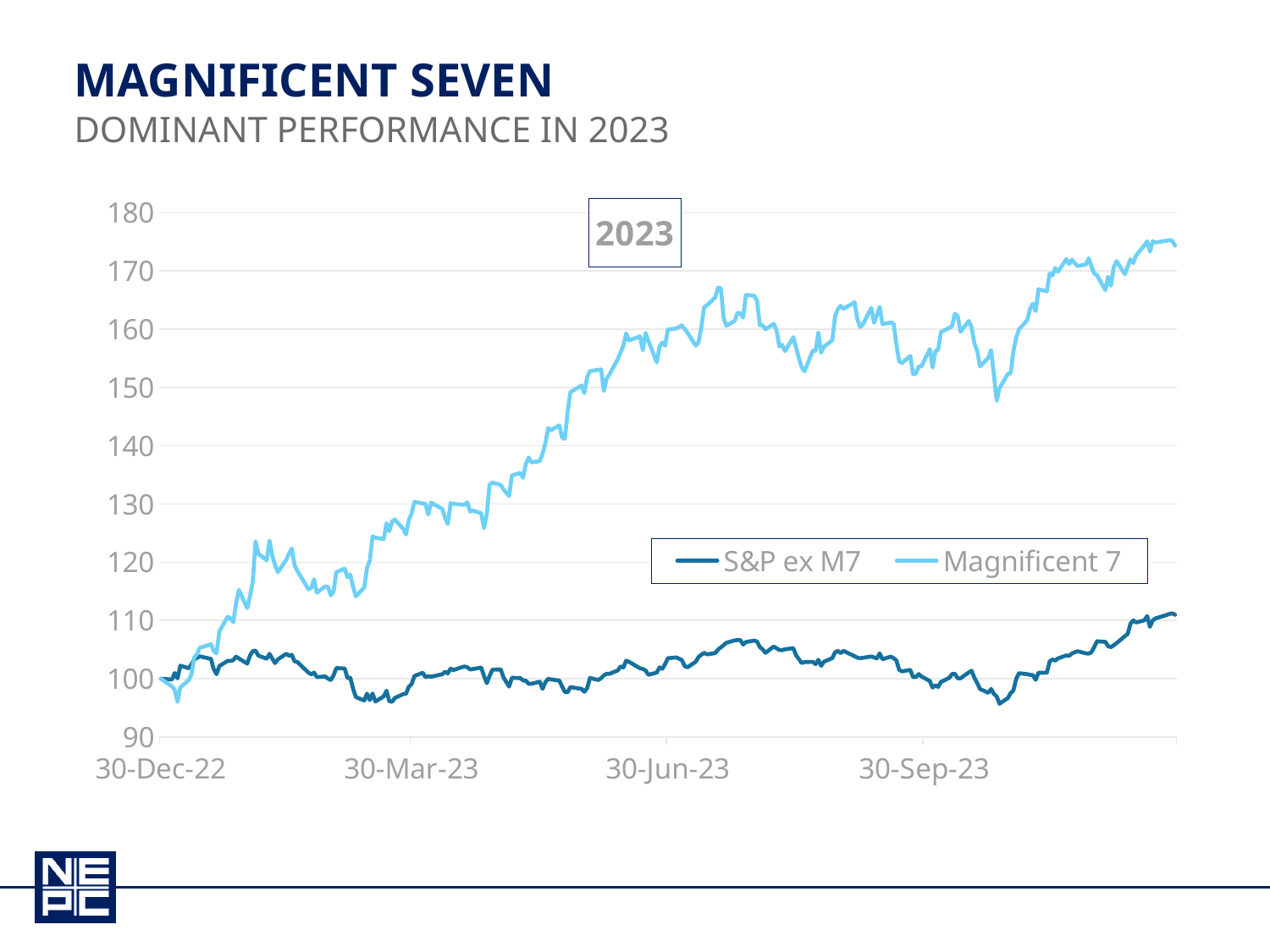
Is the value for Magnificent 7 at the end of the chart greater or less than 170? greater What kind of chart is shown on the slide? Line chart What is the title of the slide containing the chart? MAGNIFICENT SEVEN How many series does the legend list? 2 Is the value for S&P ex M7 around 30-Jun-23 greater or less than 110? less What are the two series named in the legend? S&P ex M7 and Magnificent 7 Is the value for S&P ex M7 at the end of the chart greater or less than 100? greater Does the Magnificent 7 line rise or fall overall from 30-Dec-22 to the end of the chart? Rise Which series is higher around 30-Jun-23, S&P ex M7 or Magnificent 7? Magnificent 7 Which series is higher at the end of the chart, S&P ex M7 or Magnificent 7? Magnificent 7